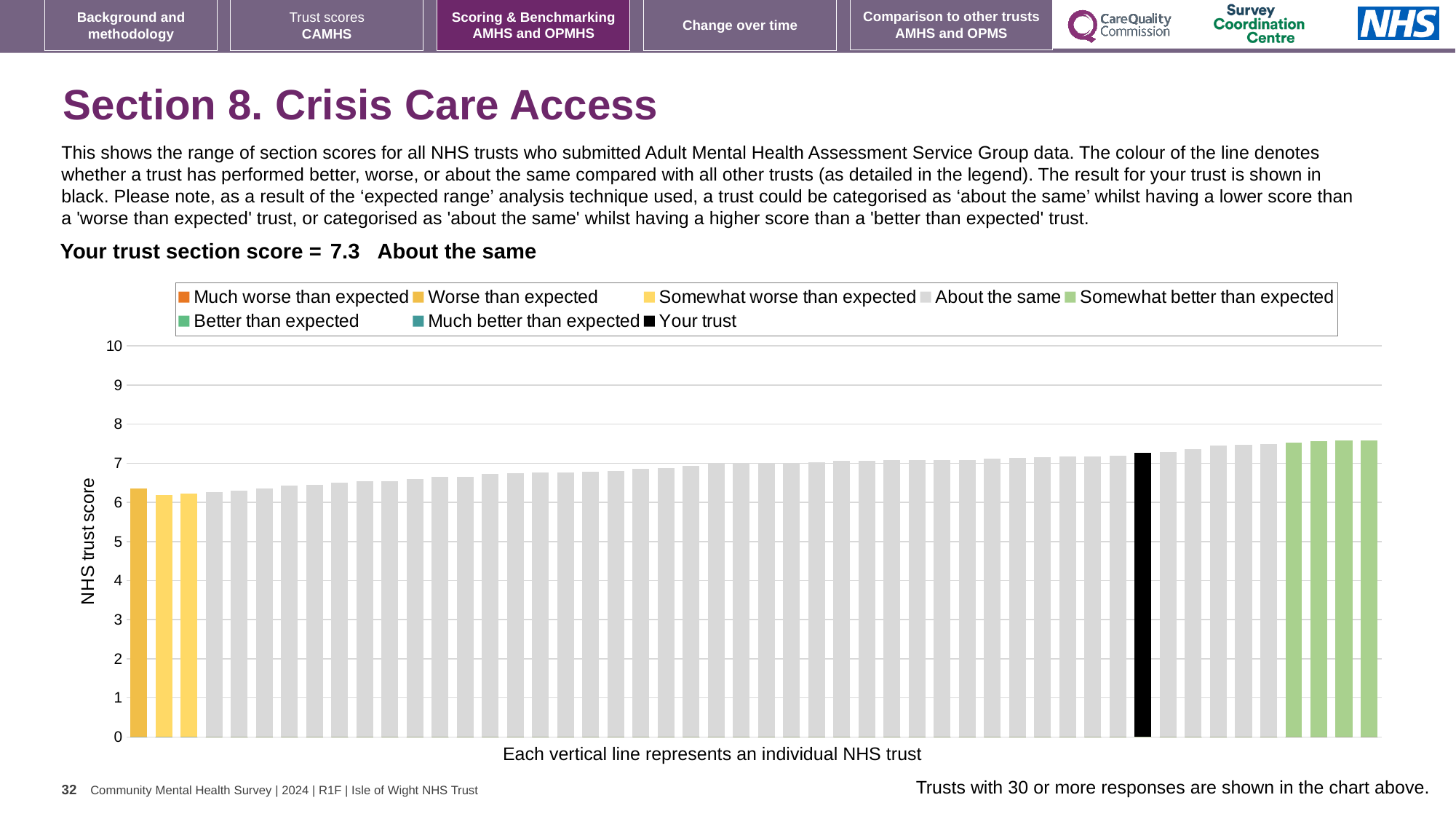
How many green 'Somewhat better than expected' bars are shown in the chart? 4 How many yellow 'Somewhat worse than expected' bars are shown in the chart? 2 What kind of chart is shown on the slide? bar chart Is the value for the black 'Your trust' bar greater or less than 7? greater Which is larger: the value for the black 'Your trust' bar or the value for the leftmost bar? Your trust Do the bar values rise or fall from left to right along the x axis? rise Is the value for the tallest bar greater or less than 8? less What is the section score for your trust shown on the slide? 7.3 Is the value for the leftmost bar greater or less than 7? less How many entries does the chart legend list? 8 What is the label on the vertical axis of the chart? NHS trust score What is the label below the horizontal axis of the chart? Each vertical line represents an individual NHS trust